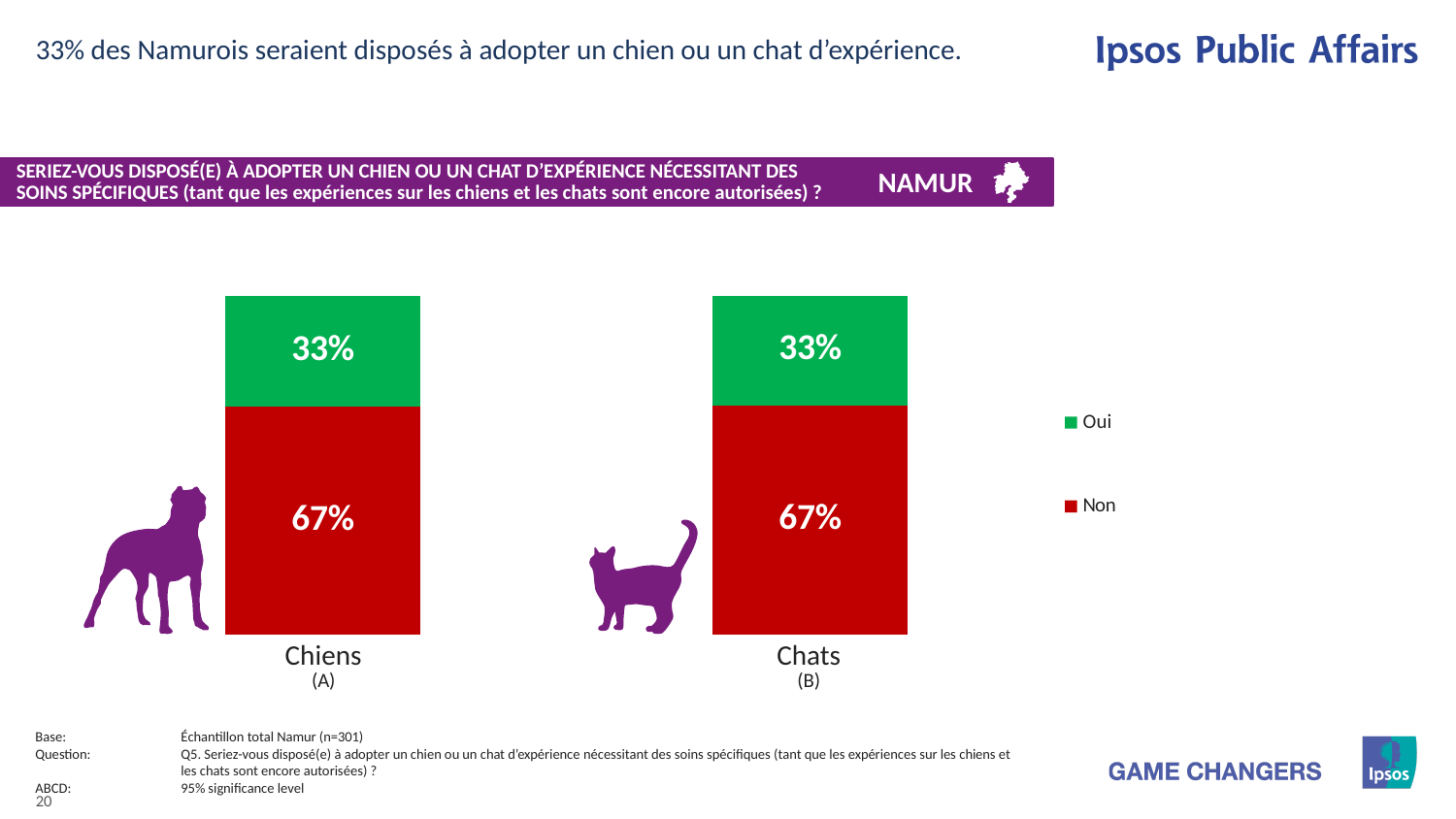
What is the difference between the 'Non' and 'Oui' shares for Chiens? 34% For Chats, which response is larger, 'Oui' or 'Non'? Non What kind of chart is shown on the slide? Stacked bar chart How many categories are shown on the x axis? 2 What percentage of respondents answered 'Non' for Chiens? 67% What percentage of respondents answered 'Oui' for Chats? 33% What is the total of the stacked bar for Chiens? 100% Which region is named in the question banner above the chart? Namur Which colour represents 'Oui' in the legend? Green What percentage of respondents answered 'Oui' for Chiens? 33% What percentage of respondents answered 'Non' for Chats? 67% How many series does the legend list? 2